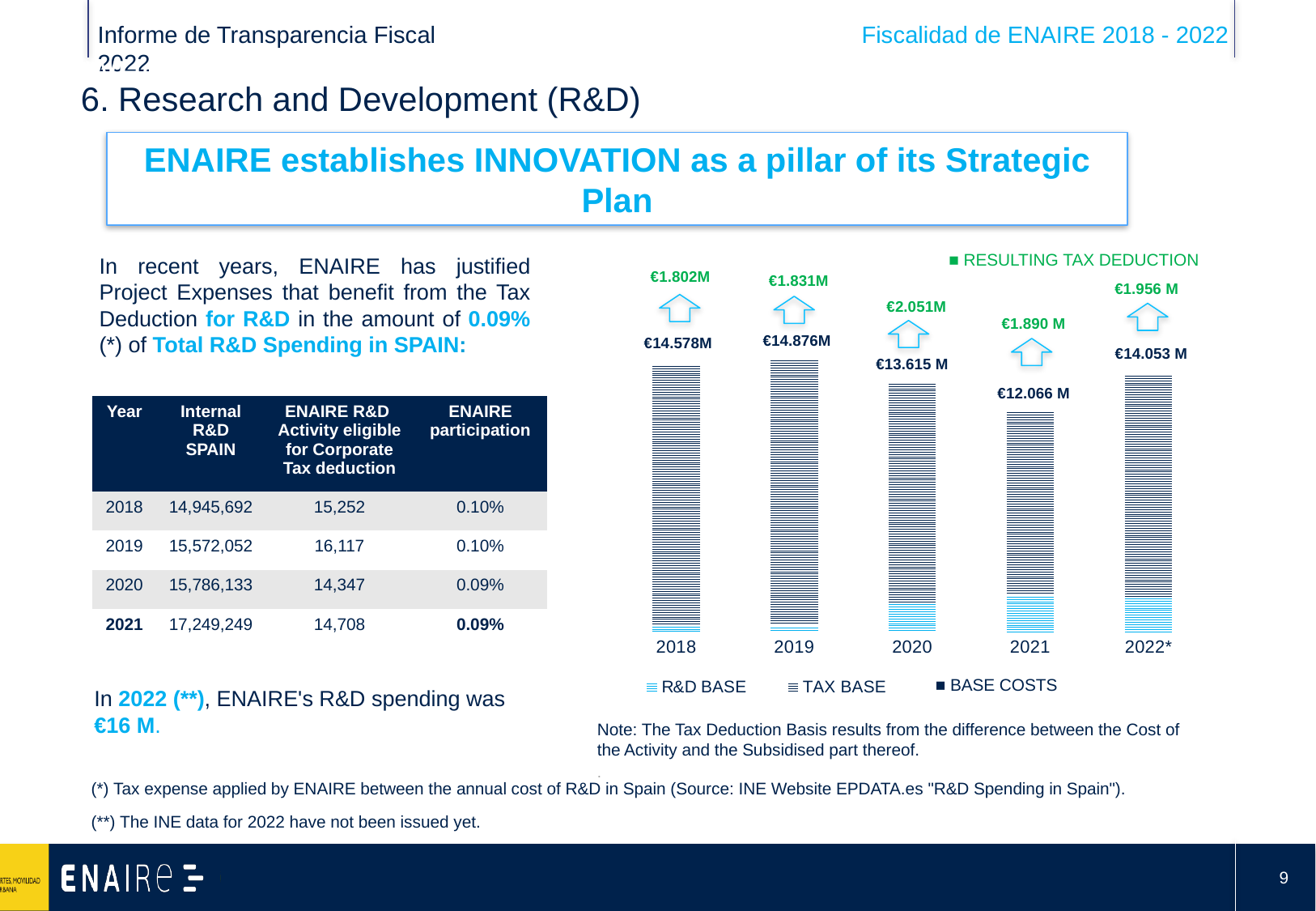
What is the bar value labelled for 2021 in the chart? €12.066 M What is the resulting tax deduction (arrow value) shown for 2022* in the chart? €1.956 M What is the difference between the bar values for 2019 and 2018 in the chart? €0.298M Which year has the lowest resulting tax deduction (arrow value) in the chart? 2018 What is the bar value labelled for 2019 in the chart? €14.876M Which is larger in the chart, the bar value for 2018 or for 2021? 2018 How many entries does the legend at the bottom of the chart list? 3 What is the resulting tax deduction (arrow value) shown for 2020 in the chart? €2.051M Which year has the lowest bar value in the chart? 2021 Which year has the highest bar value in the chart? 2019 How many years are shown on the x axis of the chart? 5 What kind of chart is shown on the right of the slide? bar chart